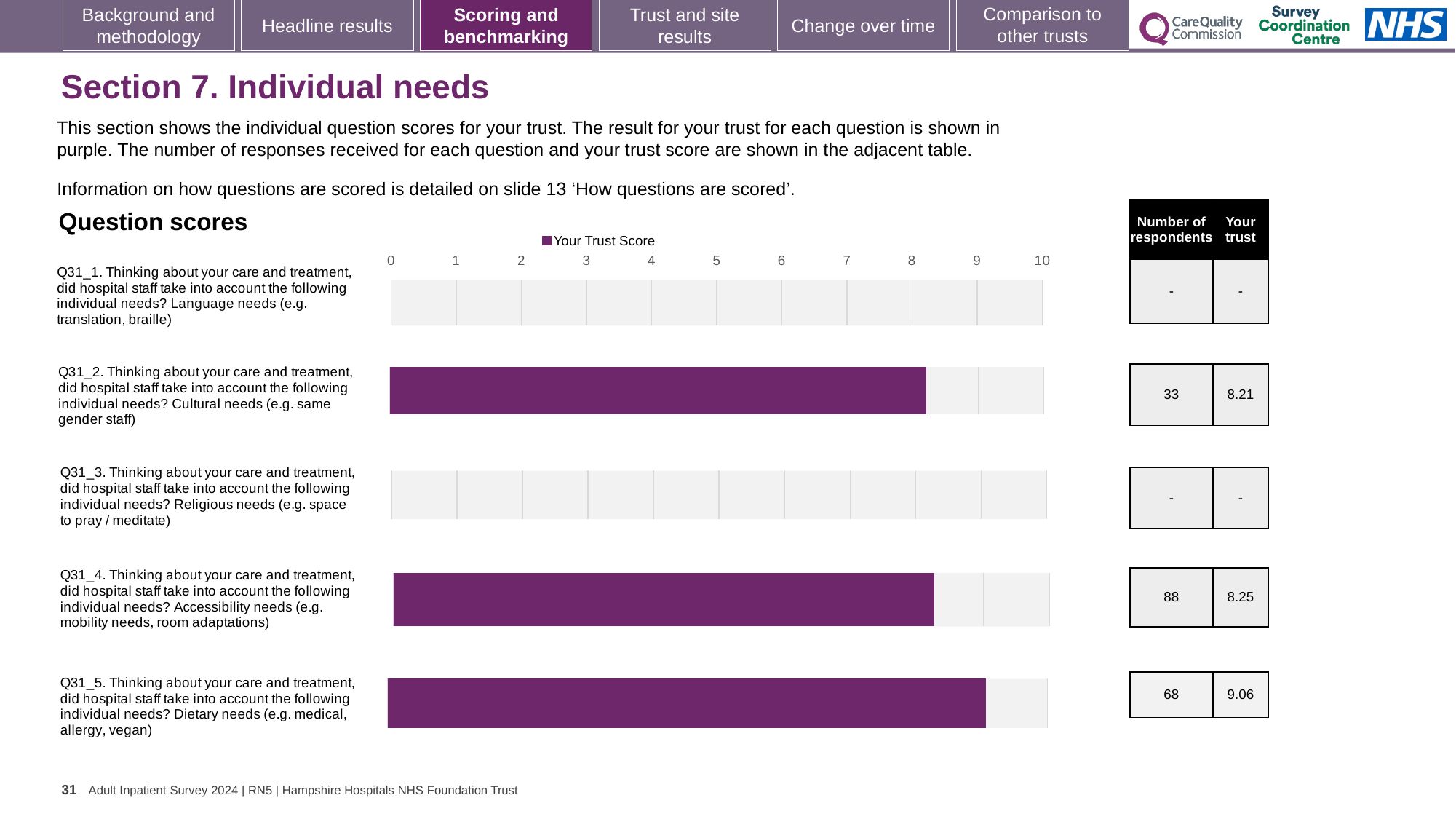
How many questions are listed in the Question scores chart? 5 What series name is shown in the chart legend? Your Trust Score How many respondents answered Q31_2 (Cultural needs)? 33 What type of chart is used to show the question scores? Bar chart Is the trust score for Q31_5 (Dietary needs) greater or less than 9? greater Which has the larger trust score, Q31_5 (Dietary needs) or Q31_4 (Accessibility needs)? Q31_5 (Dietary needs) What is the difference between the trust scores for Q31_5 (Dietary needs) and Q31_2 (Cultural needs)? 0.85 What is the trust score for Q31_4 (Accessibility needs)? 8.25 What is the trust score for Q31_2 (Cultural needs)? 8.21 What is the trust score for Q31_5 (Dietary needs)? 9.06 Which question has the highest trust score on this slide? Q31_5 (Dietary needs) How many respondents answered Q31_4 (Accessibility needs)? 88